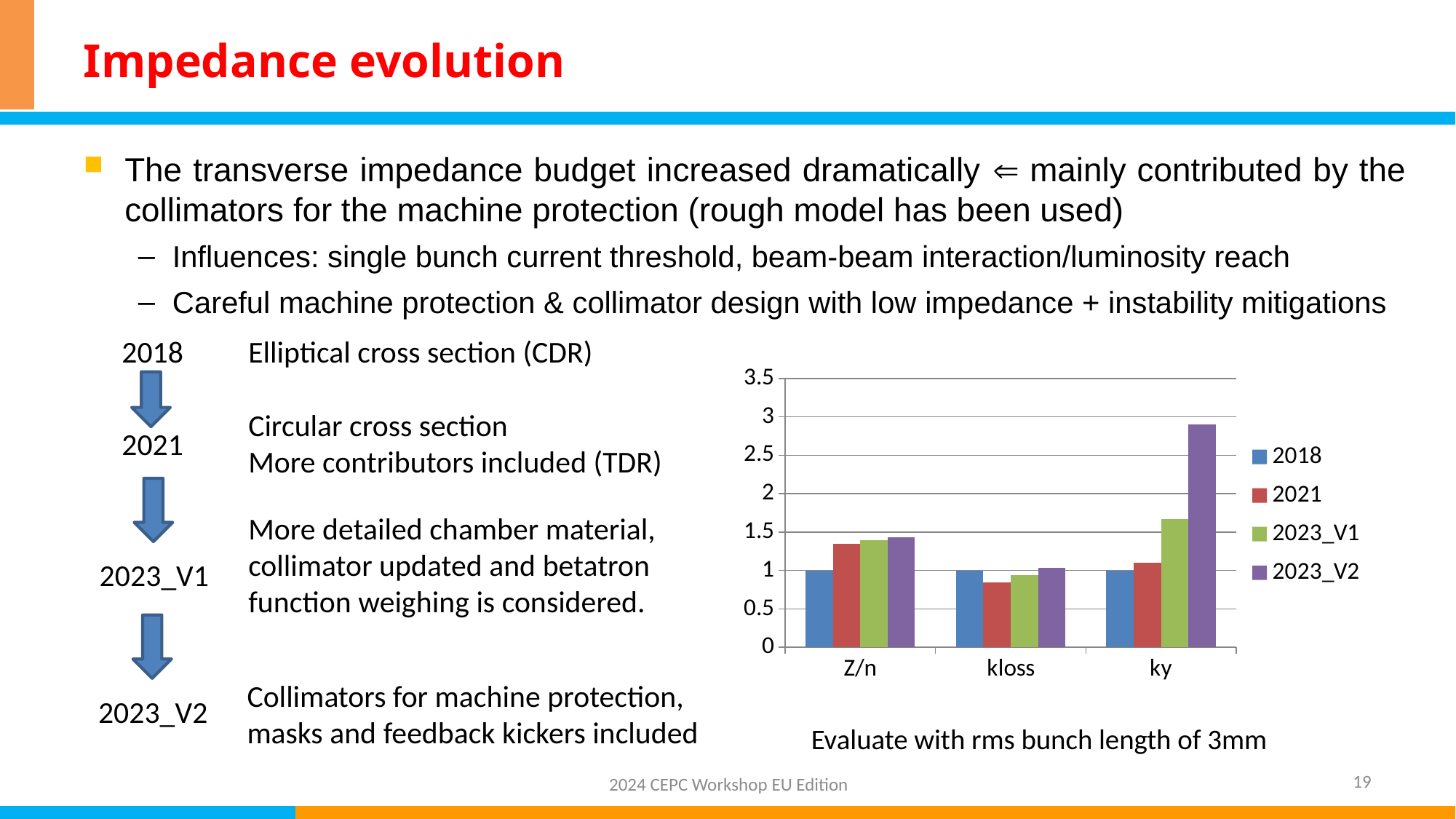
Which series has the highest value for ky? 2023_V2 Is the value for 2023_V1 in the ky category greater or less than 1.5? greater Is the value for 2023_V2 in the ky category greater or less than 2.5? greater Is the value for 2021 in the kloss category greater or less than 1? less How many series does the chart's legend list? 4 Which series has the lowest value for kloss? 2021 What text appears below the chart describing the evaluation condition? Evaluate with rms bunch length of 3mm How many categories are shown on the x axis of the chart? 3 What kind of chart is shown on the slide? bar chart What is the value for 2018 in the Z/n category? 1 Which is larger in the ky category: the value for 2023_V1 or the value for 2023_V2? 2023_V2 In the ky category, do the values rise or fall going from the 2018 series to the 2023_V2 series? rise